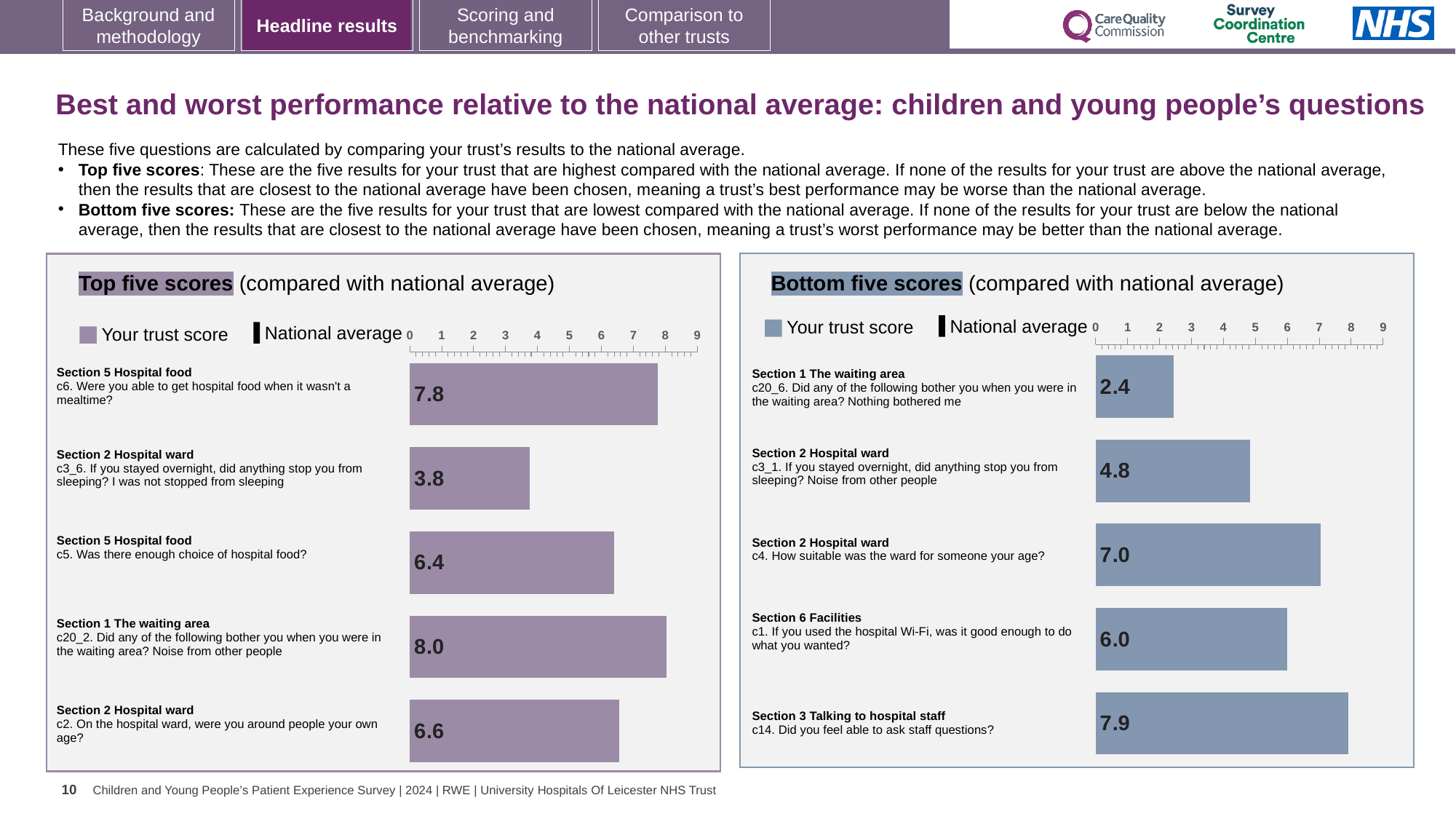
How many questions are plotted in the Bottom five scores chart? 5 In the Top five scores chart, what is the trust score for c20_2 (Noise from other people in the waiting area)? 8.0 In the Bottom five scores chart, which question has the highest trust score? c14. Did you feel able to ask staff questions? In the Bottom five scores chart, what is the trust score for c1 (hospital Wi-Fi)? 6.0 In the Bottom five scores chart, what is the trust score for c14 (Did you feel able to ask staff questions?)? 7.9 In the Top five scores chart, what is the difference between the trust scores for c20_2 and c3_6? 4.2 In the Top five scores chart, what is the trust score for c6 (Were you able to get hospital food when it wasn't a mealtime?)? 7.8 In the Bottom five scores chart, which question has the lowest trust score? c20_6. Did any of the following bother you when you were in the waiting area? Nothing bothered me What type of chart is the Top five scores chart? Bar chart In the Top five scores chart, which question has the lowest trust score? c3_6. If you stayed overnight, did anything stop you from sleeping? I was not stopped from sleeping In the Top five scores chart, which has the larger trust score: c5 (enough choice of hospital food) or c2 (around people your own age)? c2 In the Bottom five scores chart, what is the difference between the trust scores for c4 and c20_6? 4.6